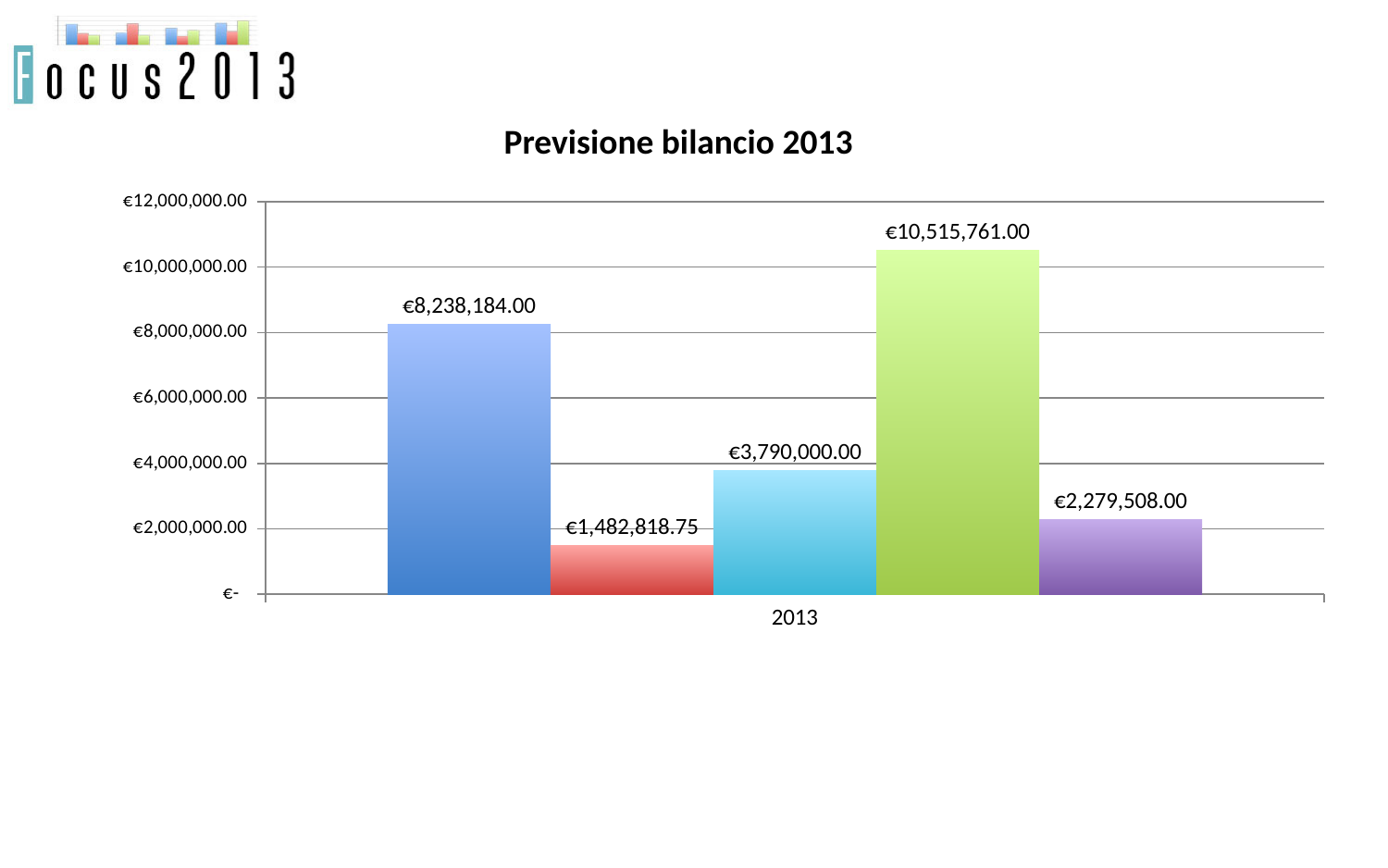
What is the value of the purple bar (rightmost)? €2,279,508.00 What is the difference between the green bar and the blue bar? €2,277,577.00 What is the value shown on the tallest bar? €10,515,761.00 What is the value of the blue bar (first from the left)? €8,238,184.00 What is the title of the chart? Previsione bilancio 2013 What is the value shown on the shortest bar? €1,482,818.75 Which is larger, the light blue bar or the purple bar? the light blue bar What category label is shown on the x axis? 2013 What type of chart is shown on the slide? bar chart What is the value of the light blue bar (third from the left)? €3,790,000.00 Is the value of the blue bar greater or less than €8,000,000.00? greater How many bars are plotted in the chart? 5